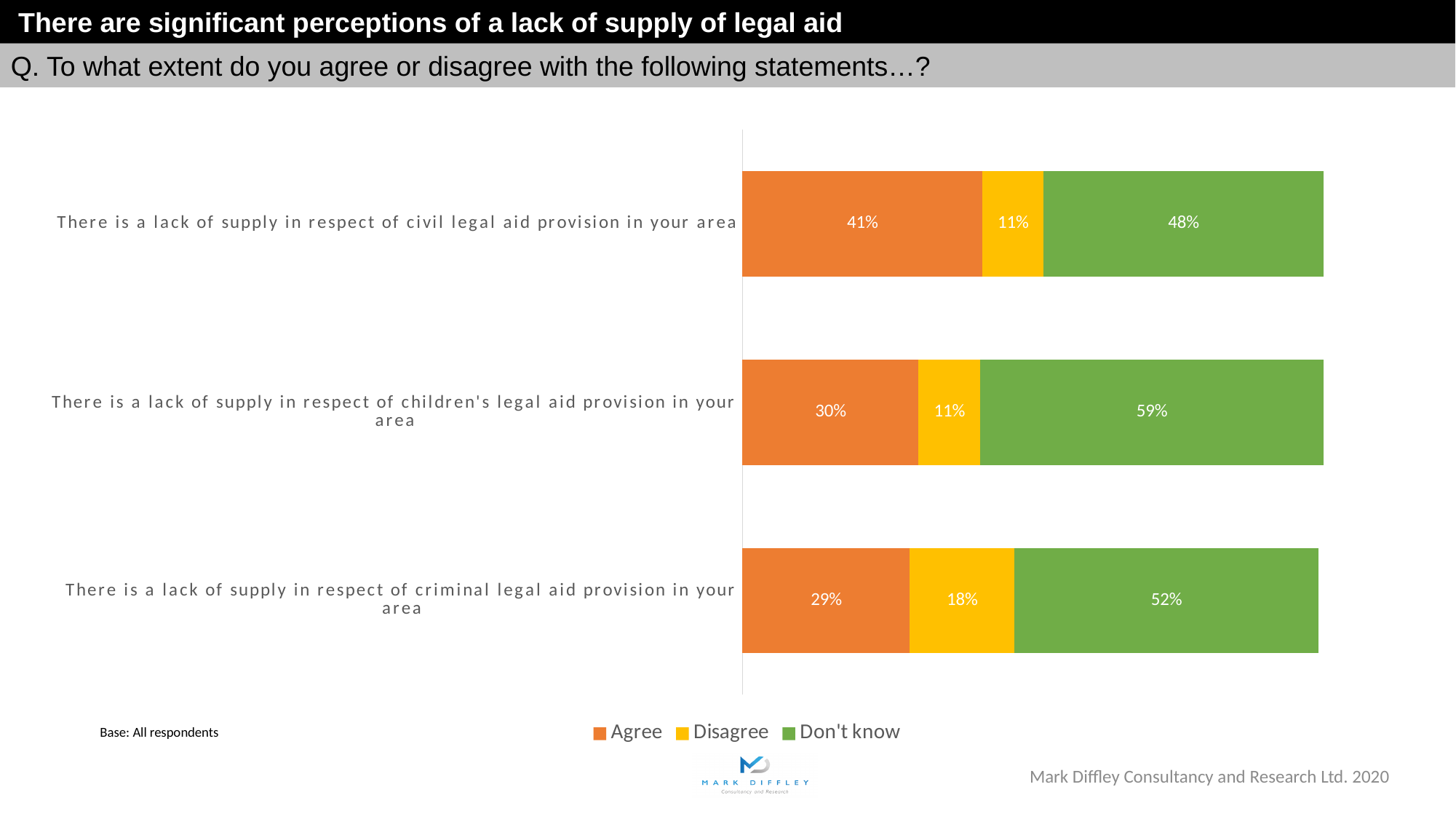
What percentage of respondents disagree that there is a lack of supply in respect of criminal legal aid provision in their area? 18% What percentage of respondents answered 'Don't know' for the statement about children's legal aid provision? 59% Which statement has the lowest 'Don't know' percentage? There is a lack of supply in respect of civil legal aid provision in your area How many series does the legend list? 3 Which colour represents 'Don't know' in the chart? Green What is the total of the stacked bar for the statement about criminal legal aid provision? 99% Is the 'Disagree' percentage higher for criminal legal aid or for children's legal aid? Criminal legal aid What type of chart is shown on the slide? Stacked bar chart What percentage of respondents agree that there is a lack of supply in respect of civil legal aid provision in their area? 41% Which statement has the highest 'Agree' percentage? There is a lack of supply in respect of civil legal aid provision in your area What is the difference between the 'Agree' percentage for civil legal aid and the 'Agree' percentage for criminal legal aid? 12% How many statements are shown in the chart? 3